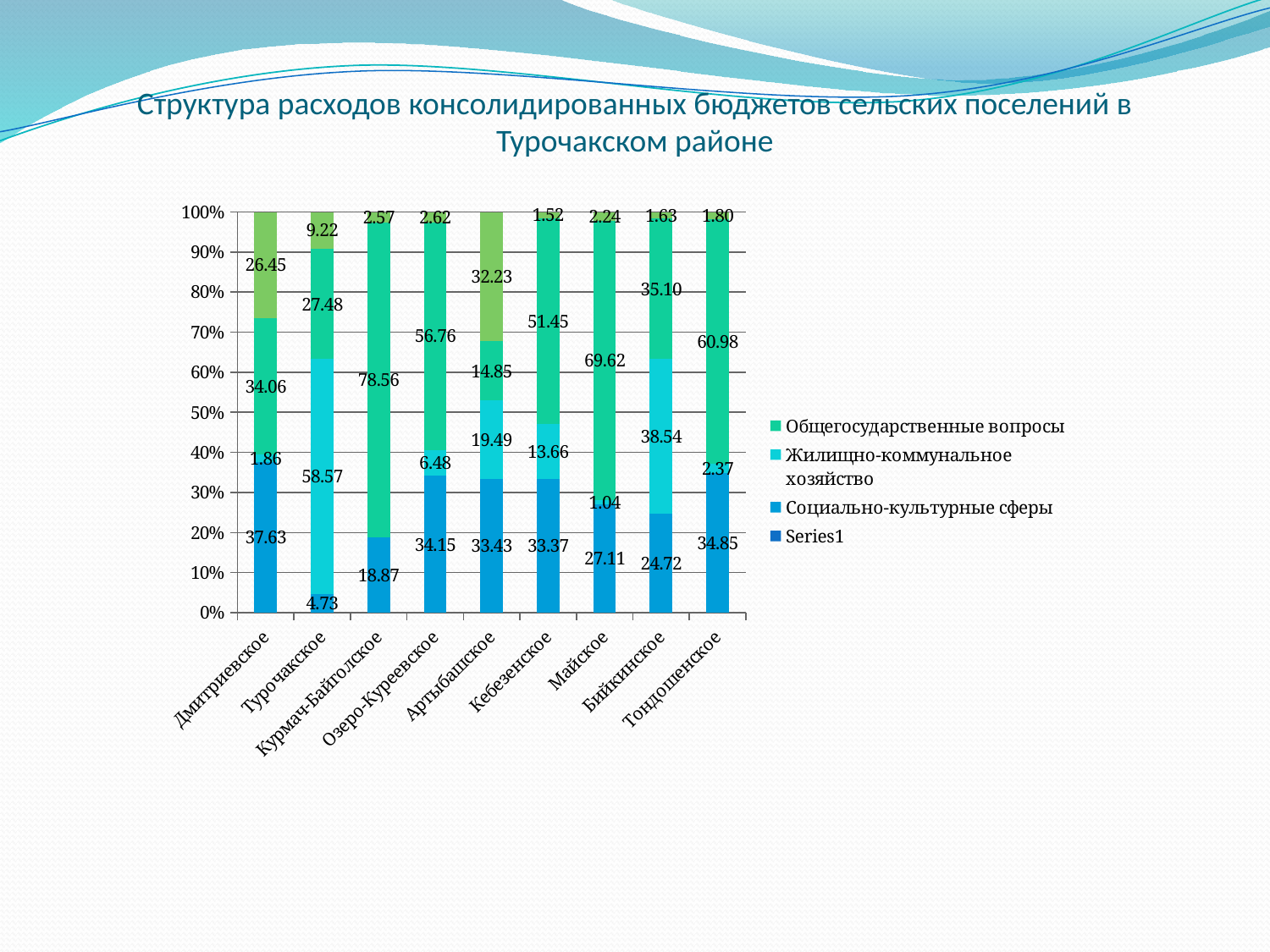
What is the value of Общегосударственные вопросы for Курмач-Байгольское? 78.56 What is the value of Жилищно-коммунальное хозяйство for Майское? 1.04 Which settlement has the lowest value for Общегосударственные вопросы? Артыбашское How many series does the chart's legend list? 4 What is the value of Жилищно-коммунальное хозяйство for Турочакское? 58.57 What is the value of Жилищно-коммунальное хозяйство for Бийкинское? 38.54 Which settlement has the larger value for Общегосударственные вопросы, Майское or Тондошенское? Майское What is the difference between the Общегосударственные вопросы values for Озеро-Куреевское and Кебезенское? 5.31 How many settlements (categories) are shown on the x axis of the chart? 9 What kind of chart is shown on the slide? Stacked bar chart Which settlement has the highest value for Общегосударственные вопросы? Курмач-Байгольское What is the title of the chart on the slide? Структура расходов консолидированных бюджетов сельских поселений в Турочакском районе